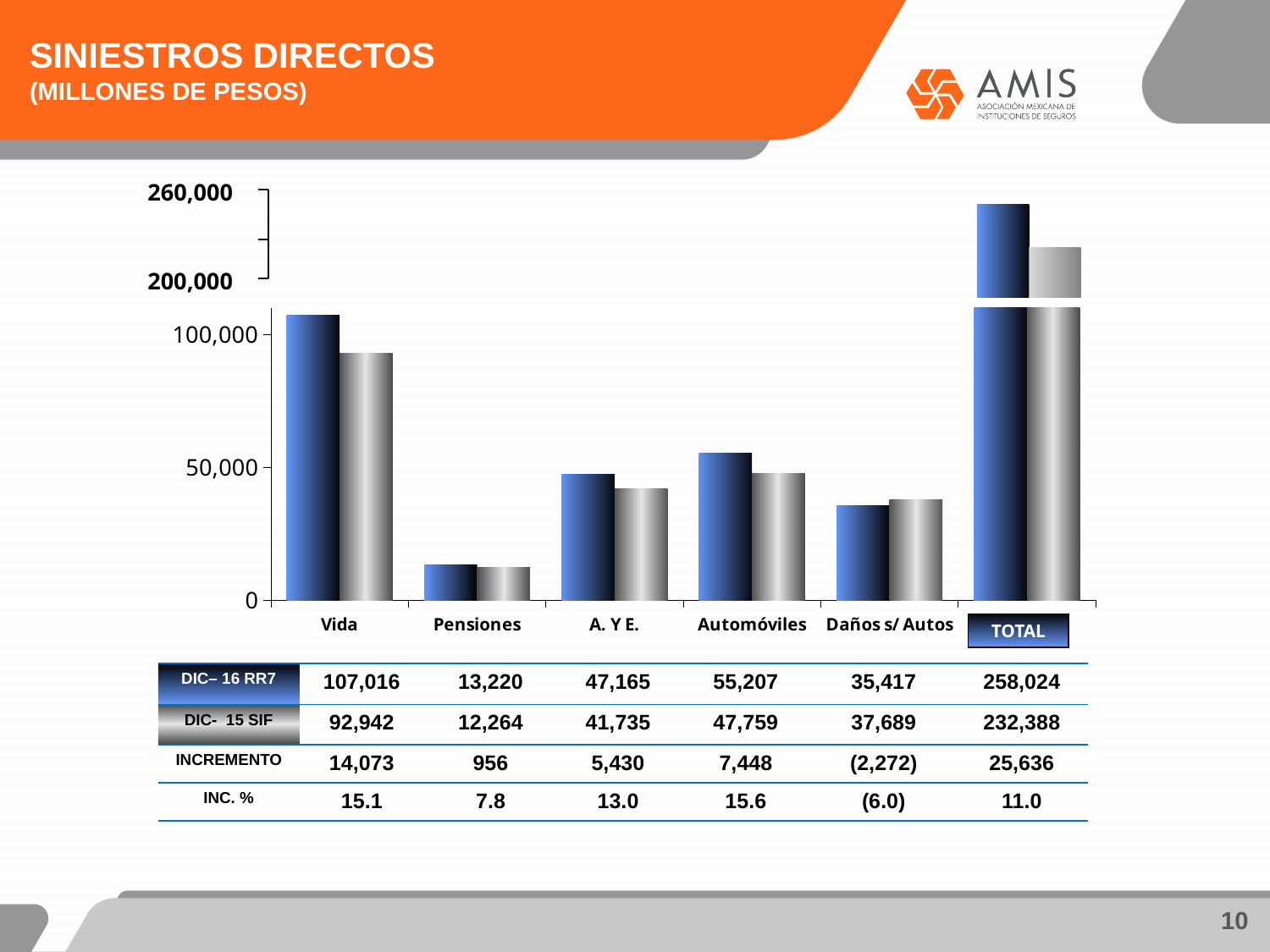
What is the INCREMENTO value for Pensiones? 956 Excluding TOTAL, which category has the highest DIC–16 RR7 value? Vida What type of chart is shown on the slide? Bar chart For Daños s/ Autos, which is larger: the DIC–16 RR7 value or the DIC-15 SIF value? DIC-15 SIF What is the DIC-15 SIF value for Automóviles? 47,759 Which category has the lowest DIC-15 SIF value? Pensiones How many categories are shown on the x axis, including TOTAL? 6 How many data series are plotted in the chart? 2 What is the difference between the DIC–16 RR7 and DIC-15 SIF values for A. Y E.? 5,430 What is the DIC–16 RR7 value for Vida? 107,016 What is the DIC–16 RR7 value for Daños s/ Autos? 35,417 Is the DIC–16 RR7 value for Automóviles greater or less than 50,000? greater